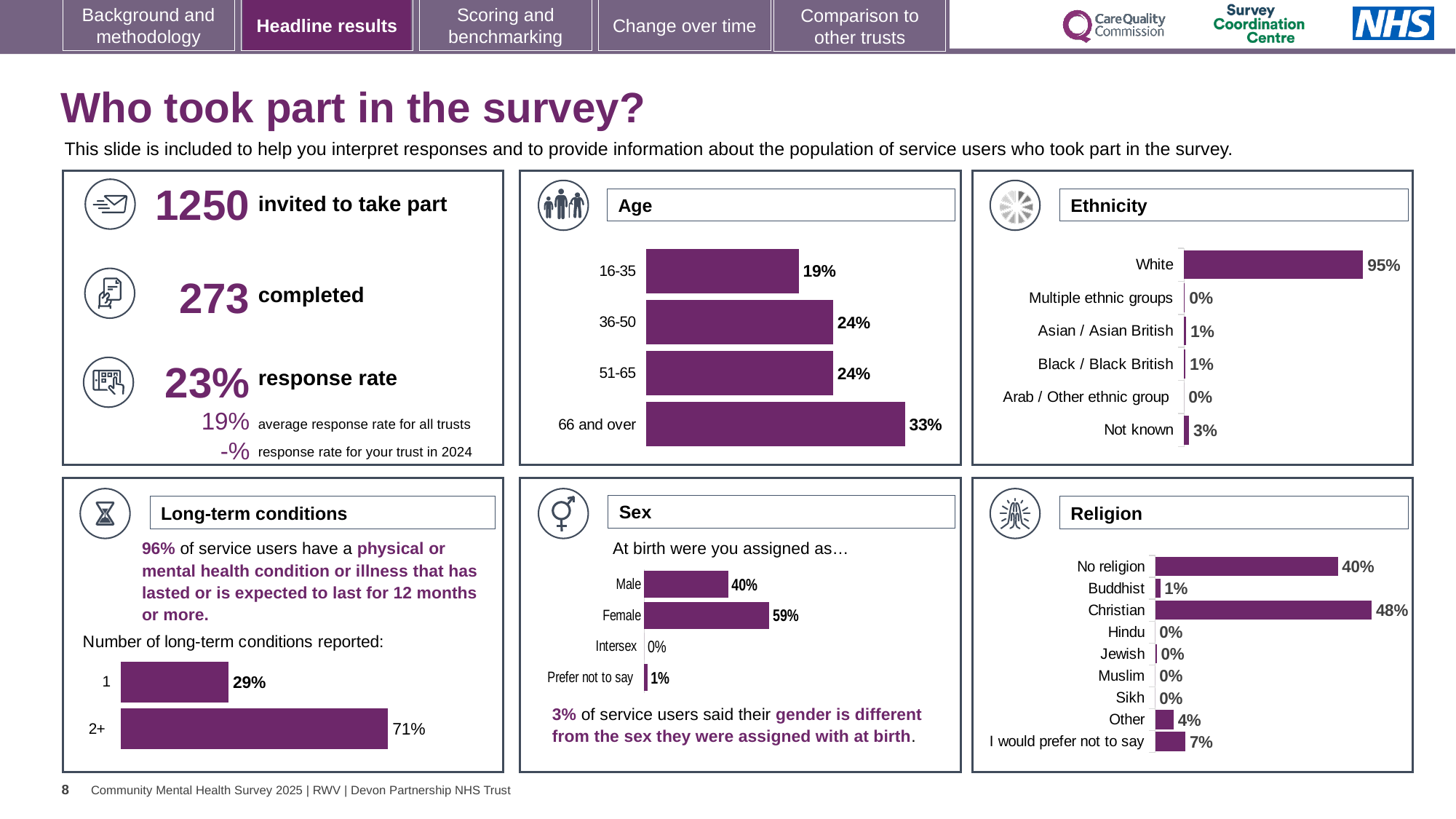
In the Ethnicity chart, how many ethnicity categories are listed? 6 In the Age chart, which age group has the lowest percentage? 16-35 In the Religion chart, which category has the highest percentage? Christian In the Religion chart, what percentage of respondents said 'I would prefer not to say'? 7% In the Long-term conditions chart, what is the difference between the percentages for 2+ and 1 conditions? 42% In the Age chart, what percentage of respondents were aged 66 and over? 33% In the Sex chart, which is larger, Male or Female? Female In the Age chart, how many age categories are shown? 4 What type of chart is used in the Age panel? Bar chart In the Ethnicity chart, what percentage of respondents were White? 95% In the Sex chart, what percentage of respondents were assigned Female at birth? 59% In the Ethnicity chart, what is the difference between the White and Not known percentages? 92%